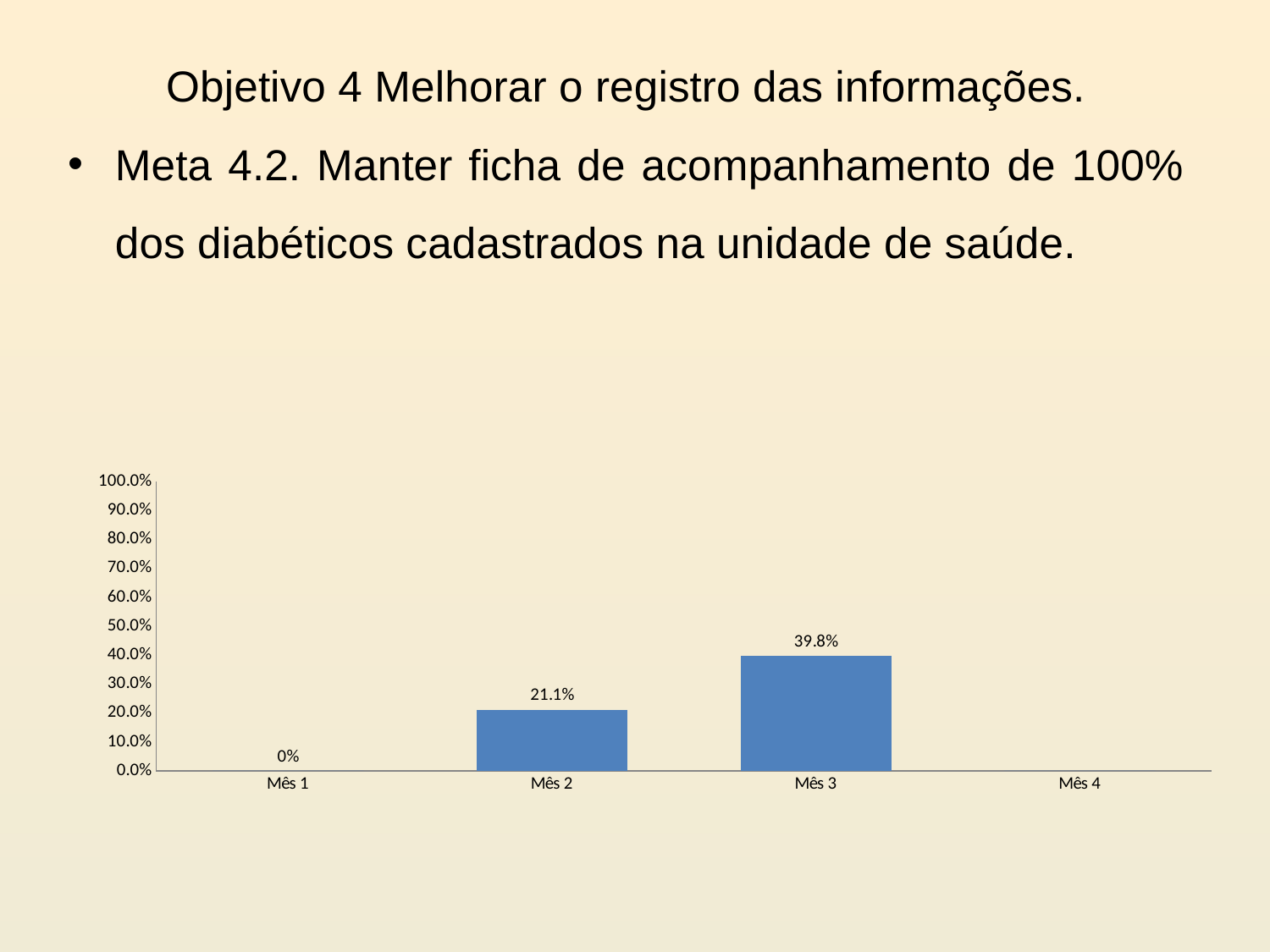
What is the difference between the values for Mês 3 and Mês 2? 18.7% Which month has the highest value? Mês 3 Is the value for Mês 2 greater or less than 10%? greater Do the values rise or fall from Mês 1 to Mês 3? rise What is the value for Mês 2? 21.1% Which is larger, the value for Mês 2 or the value for Mês 3? Mês 3 What is the difference between the values for Mês 2 and Mês 1? 21.1% What is the value shown for Mês 1? 0% Is the value for Mês 3 greater or less than 50%? less How many month categories are labeled on the x axis? 4 What is the value for Mês 3? 39.8% What kind of chart is shown on the slide? bar chart